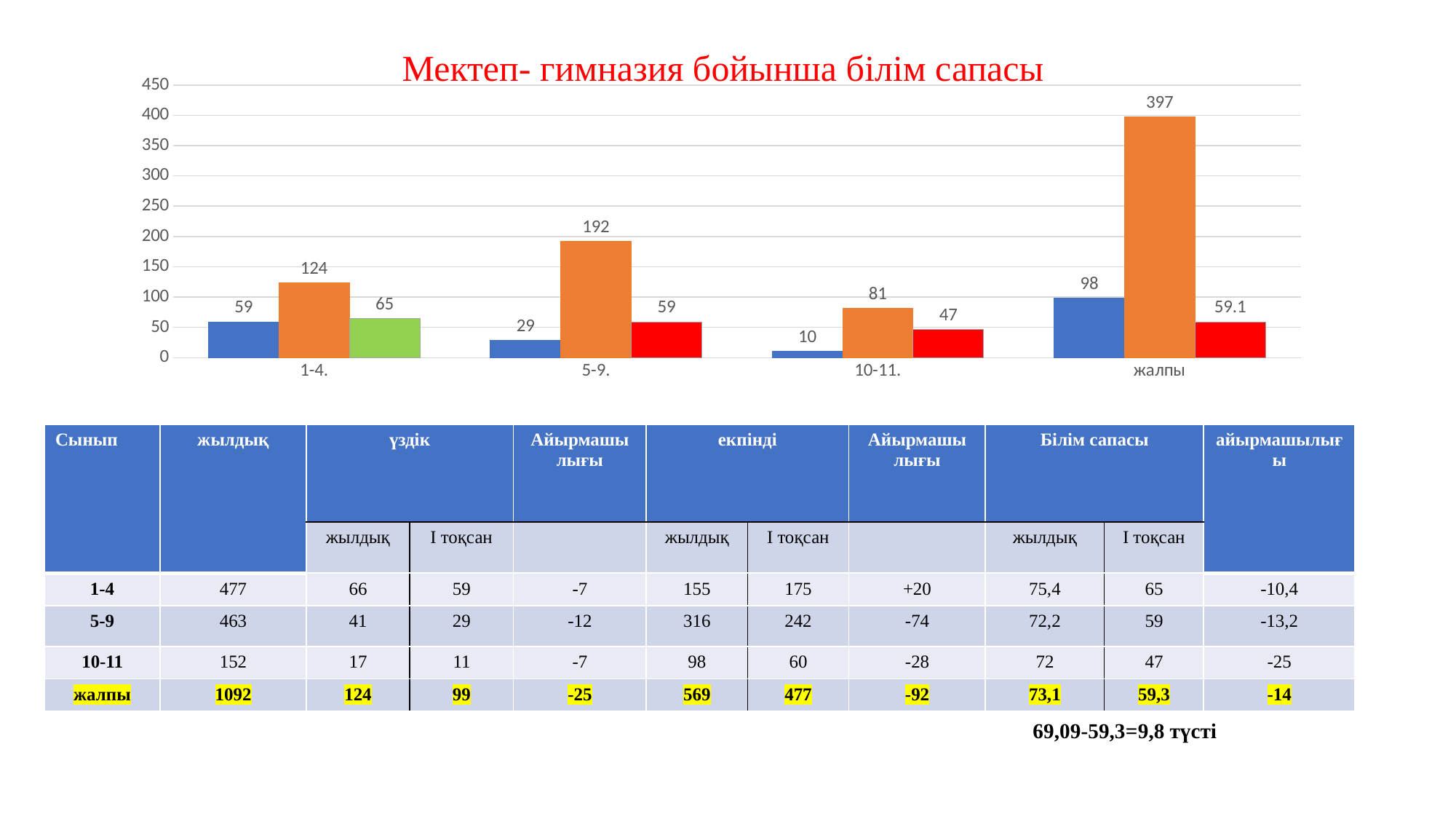
Which category has the lowest blue bar? 10-11. Which is larger: the blue bar for '1-4.' or the blue bar for '5-9.'? 1-4. What is the value of the blue bar for the category '5-9.'? 29 Which category has the highest orange bar? жалпы What is the difference between the orange bar values for '5-9.' and '1-4.'? 68 What kind of chart is shown on the slide? bar chart What is the value of the orange bar for the category 'жалпы'? 397 Is the orange bar for '10-11.' greater or less than 100? less What is the value of the green bar for the category '1-4.'? 65 How many categories are shown on the x axis of the chart? 4 What is the value of the red bar for the category '10-11.'? 47 What is the title of the chart? Мектеп- гимназия бойынша білім сапасы